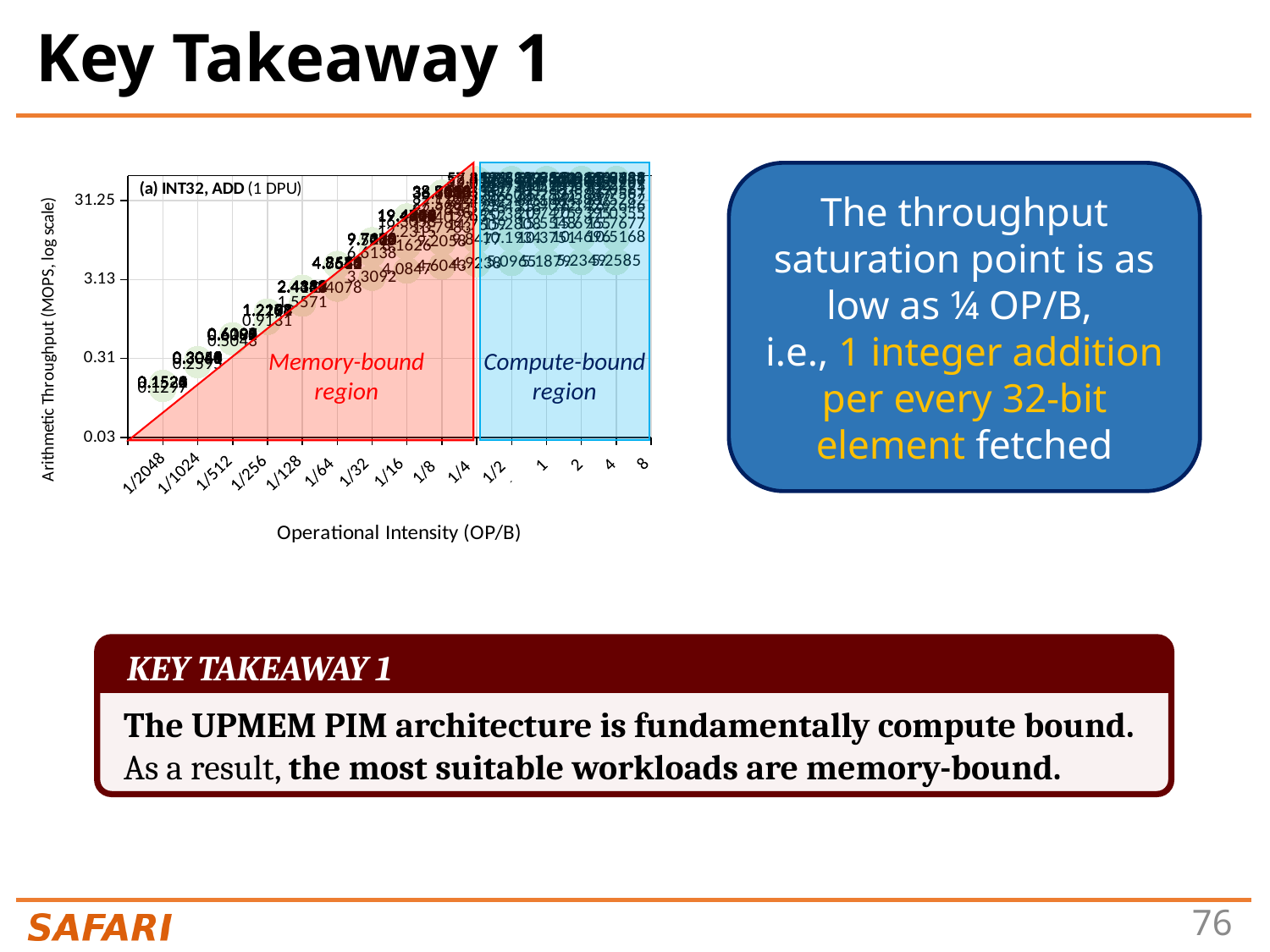
How many operational intensity values are marked on the x axis? 15 Which has the higher arithmetic throughput: operational intensity 1/2048 or operational intensity 8? 8 Which operational intensity has the lowest arithmetic throughput? 1/2048 Which has the higher arithmetic throughput: operational intensity 1/64 or operational intensity 1/512? 1/64 What kind of chart is shown on the slide? scatter chart Is the arithmetic throughput at operational intensity 8 greater or less than 3.13 MOPS? greater What are the two regions marked on the chart? Memory-bound region and Compute-bound region What is the label of the x axis of the chart? Operational Intensity (OP/B) Is the arithmetic throughput at operational intensity 1/2048 greater or less than 0.03 MOPS? greater Is the arithmetic throughput at operational intensity 1/4 greater or less than 3.13 MOPS? greater How does arithmetic throughput change as operational intensity increases from 1/2048 to 1/4? it rises